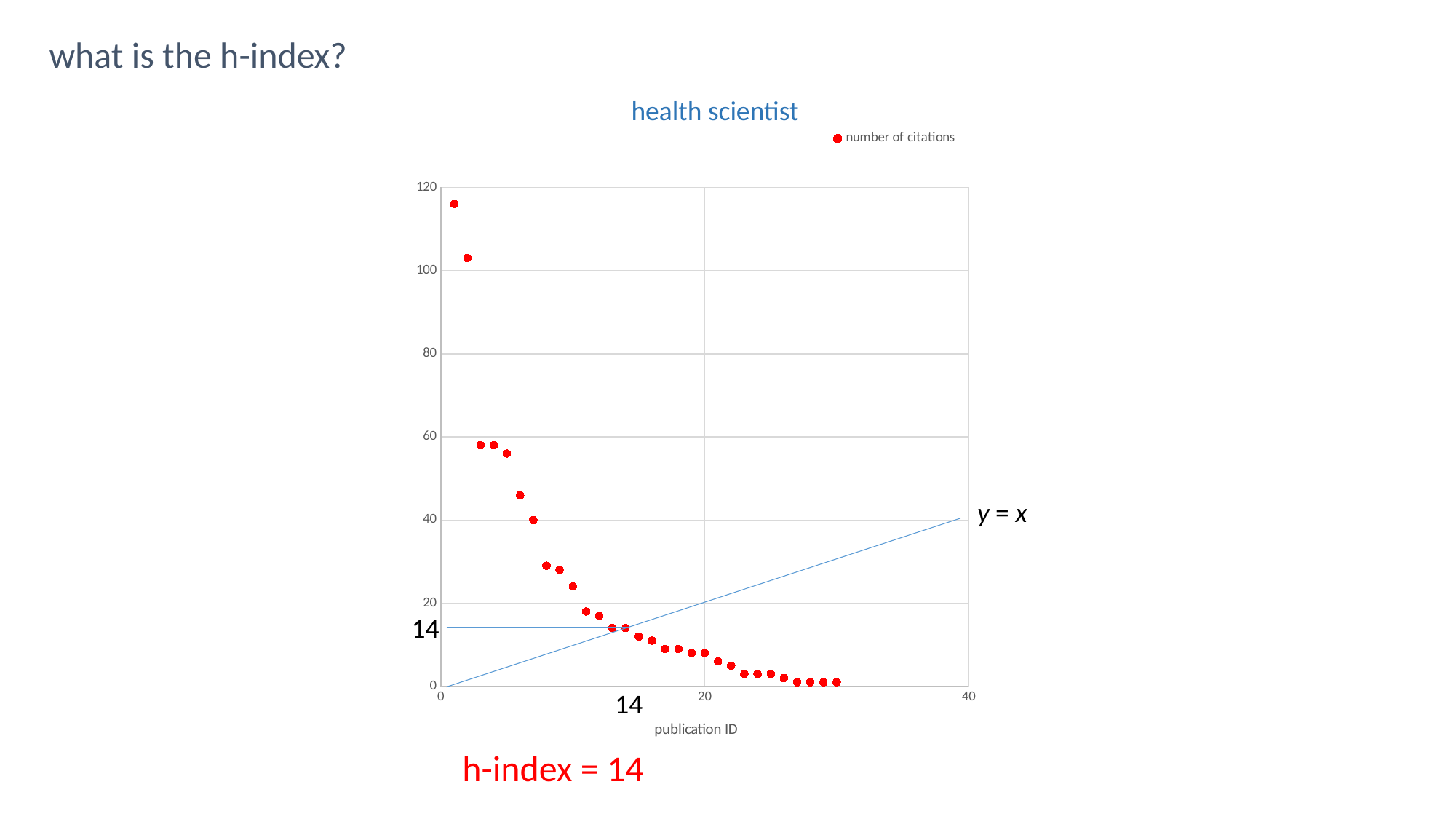
Is the number of citations for publication ID 30 greater or less than 20? less What is the number of citations at publication ID 14, as marked on the chart? 14 What is the label of the x axis? publication ID How many series does the chart legend list? 1 Do the number of citations values rise or fall as publication ID increases? fall Is the number of citations for publication ID 1 greater or less than 100? greater Is the number of citations for publication ID 6 greater or less than 40? greater What kind of chart is shown on the slide? scatter chart What h-index value is stated on the slide? 14 Which publication ID has the highest number of citations? 1 What is the title of the chart? health scientist